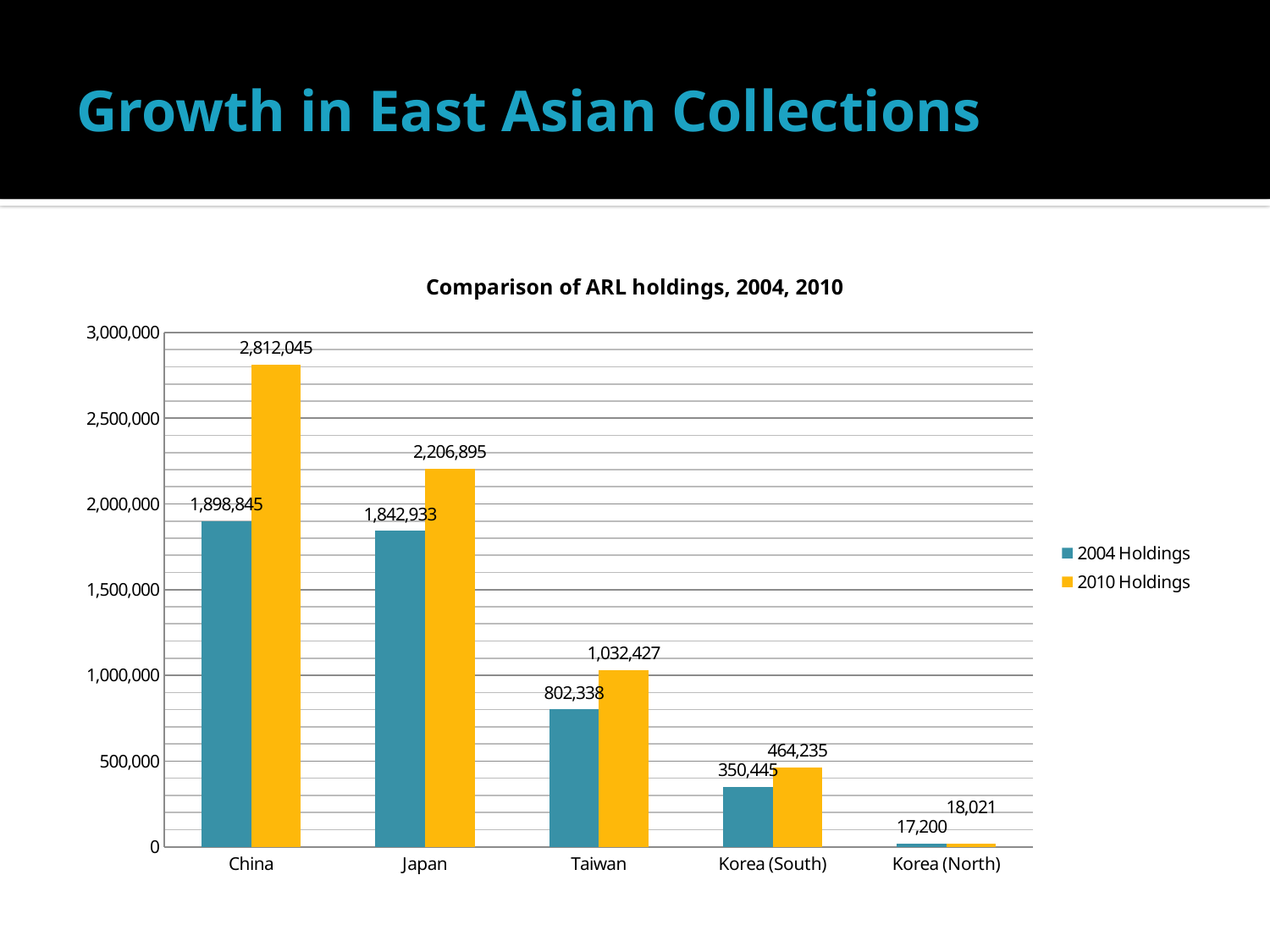
What is the difference between the 2010 Holdings and 2004 Holdings for Japan? 363,962 What is the 2004 Holdings value for Korea (North)? 17,200 What is the 2004 Holdings value for Taiwan? 802,338 How many series does the legend list? 2 How many countries are shown on the x axis? 5 Which country has the highest 2010 Holdings? China Is the 2010 Holdings value for Taiwan greater or less than 1,000,000? greater What kind of chart is shown on the slide? Bar chart What is the title of the chart? Comparison of ARL holdings, 2004, 2010 What is the 2010 Holdings value for China? 2,812,045 Which country has the lowest 2004 Holdings? Korea (North) Which is larger: the 2004 Holdings for China or the 2004 Holdings for Japan? 2004 Holdings for China